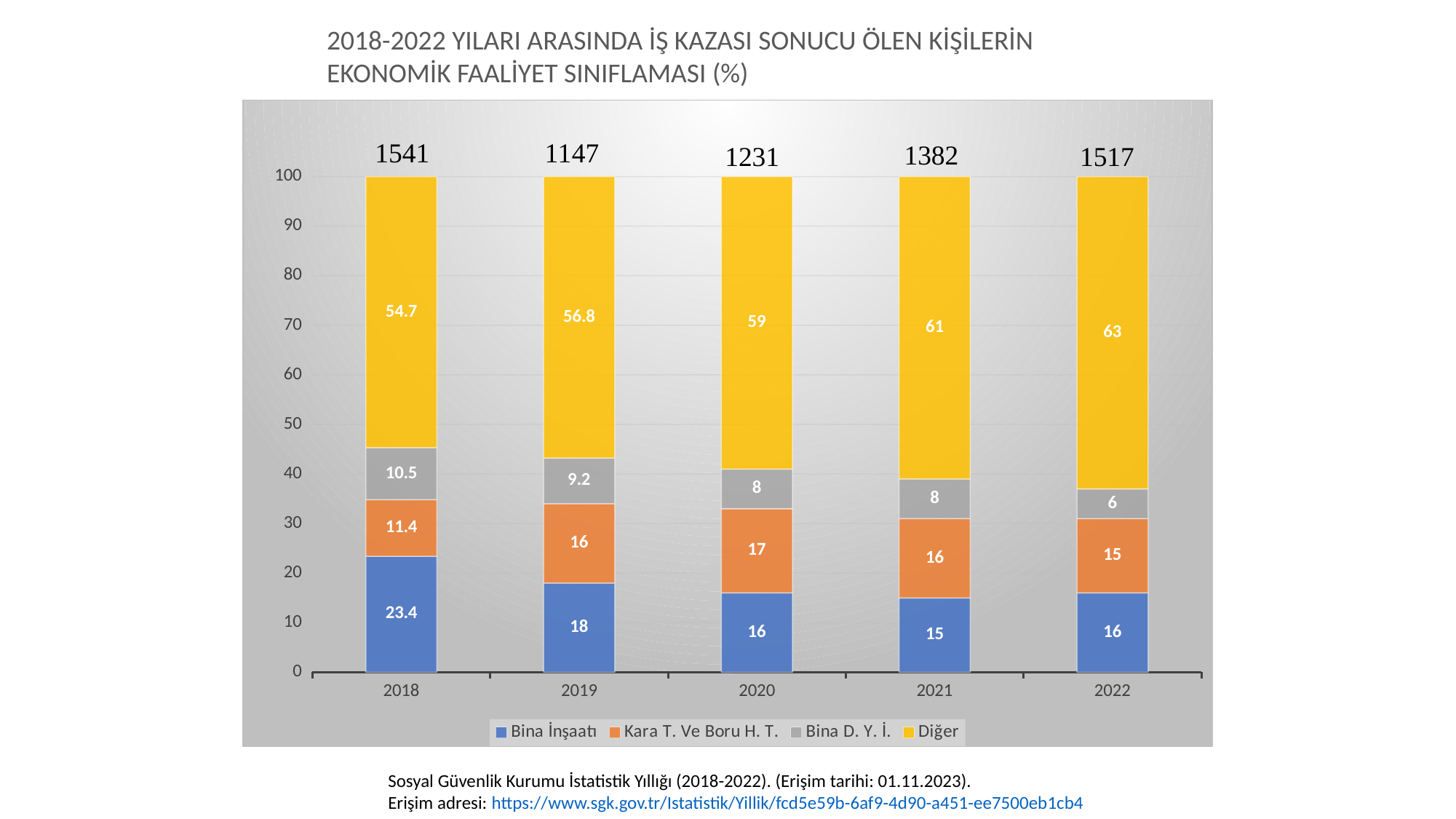
What is the value for Bina İnşaatı in 2018? 23.4 Does the Diğer share rise or fall from 2018 to 2022? Rise How many series does the legend list? 4 What kind of chart is shown on the slide? Stacked bar chart What number is printed above the bar for 2019? 1147 How many years are shown on the x axis? 5 What is the value for Diğer in 2022? 63 In which year is the Diğer share highest? 2022 In which year is the Bina İnşaatı share lowest? 2021 What is the value for Bina D. Y. İ. in 2019? 9.2 What is the value for Kara T. Ve Boru H. T. in 2020? 17 What is the difference between the Diğer values for 2022 and 2018? 8.3